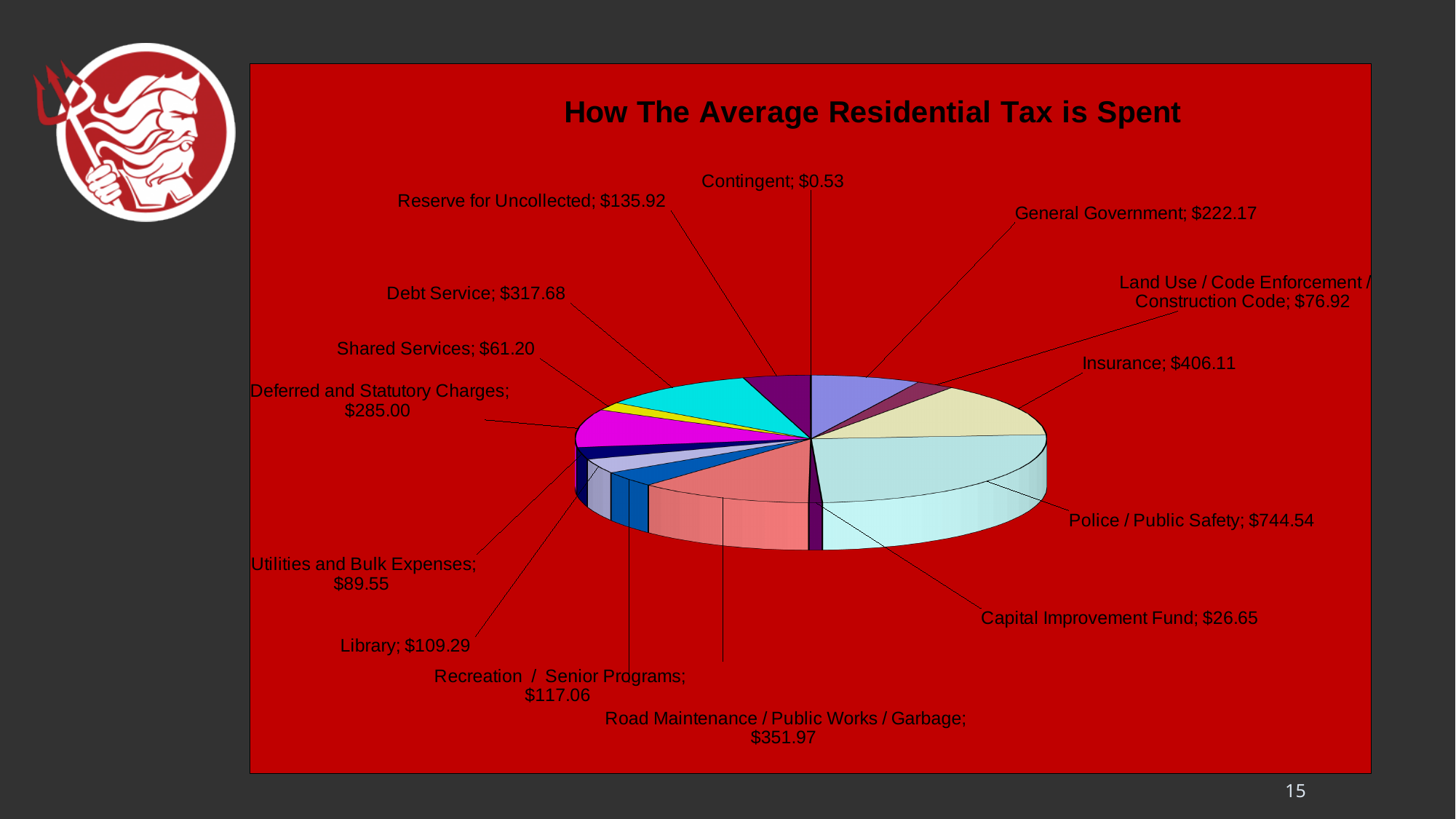
What is the difference between the Police / Public Safety value and the Insurance value? $338.43 How much of the average residential tax goes to Police / Public Safety? $744.54 What is the value shown for Insurance? $406.11 What is the difference between Debt Service and Deferred and Statutory Charges? $32.68 Which category has the largest value in the pie chart? Police / Public Safety What is the value shown for Reserve for Uncollected? $135.92 What is the value shown for Road Maintenance / Public Works / Garbage? $351.97 Which category has the smallest value in the pie chart? Contingent What is the title of the chart? How The Average Residential Tax is Spent How many categories are shown in the pie chart? 14 Which is larger, Library or Recreation / Senior Programs? Recreation / Senior Programs What type of chart is shown on the slide? Pie chart